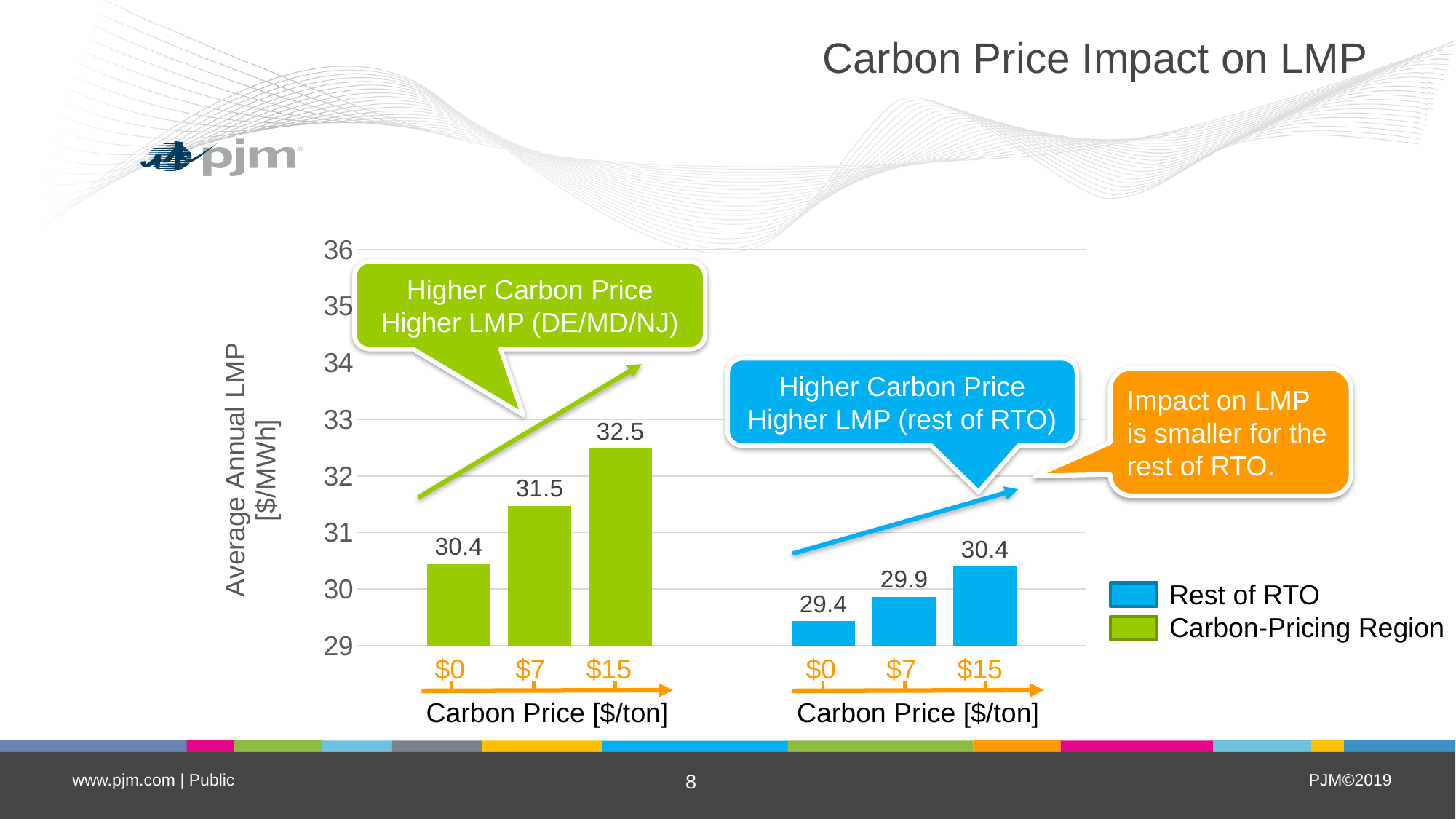
How many series does the legend list? 2 Which carbon price gives the lowest average annual LMP for the Rest of RTO? $0 Which carbon price gives the highest average annual LMP for the Carbon-Pricing Region? $15 What is the average annual LMP for the Carbon-Pricing Region at a $7/ton carbon price? 31.5 What is the average annual LMP for the Rest of RTO at a $0/ton carbon price? 29.4 What is the average annual LMP for the Rest of RTO at a $15/ton carbon price? 30.4 What is the difference between the Carbon-Pricing Region LMP at $15/ton and at $0/ton? 2.1 At a $7/ton carbon price, which is larger: the Carbon-Pricing Region LMP or the Rest of RTO LMP? Carbon-Pricing Region Which colour represents the Carbon-Pricing Region in the legend? Green What kind of chart is shown on the slide? Bar chart What is the difference between the Rest of RTO LMP at $15/ton and at $0/ton? 1.0 Do the Rest of RTO values rise or fall as the carbon price increases? Rise